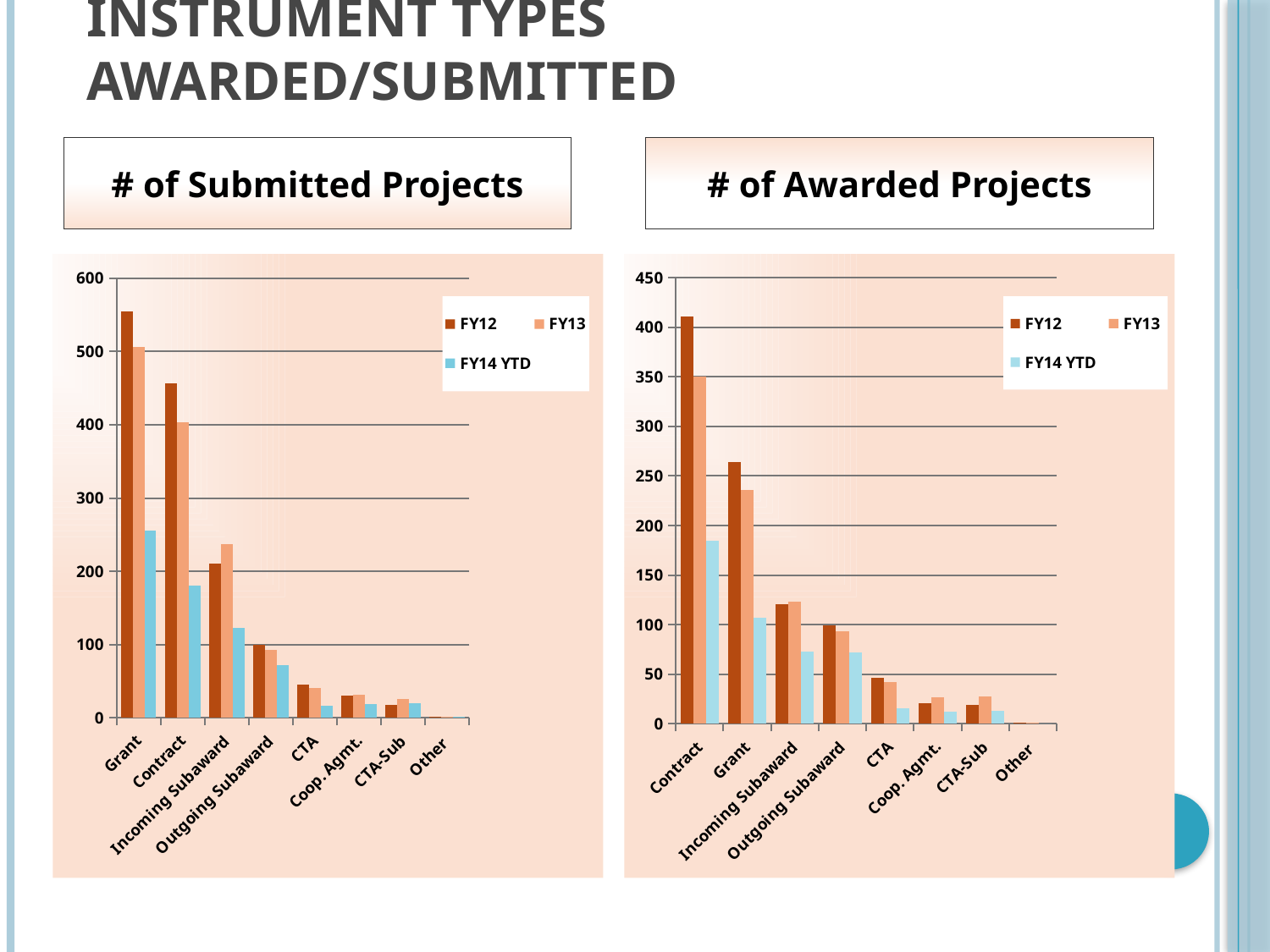
How many categories are shown on the x axis of the "# of Submitted Projects" chart? 8 In the "# of Submitted Projects" chart, is the FY12 value for Grant greater or less than 500? greater In the "# of Submitted Projects" chart, which is larger for Contract: the FY12 value or the FY14 YTD value? FY12 In the "# of Submitted Projects" chart, which category has the lowest values across all series? Other In the "# of Awarded Projects" chart, which is larger: the FY13 value for Contract or the FY13 value for Grant? Contract In the "# of Submitted Projects" chart, which category has the highest FY12 value? Grant What kind of chart is the "# of Awarded Projects" chart? Bar chart In the "# of Awarded Projects" chart, is the FY14 YTD value for Grant greater or less than 150? less How many series does the legend of the "# of Awarded Projects" chart list? 3 In the "# of Awarded Projects" chart, is the FY12 value for Contract greater or less than 400? greater In the "# of Awarded Projects" chart, which category has the highest FY12 value? Contract